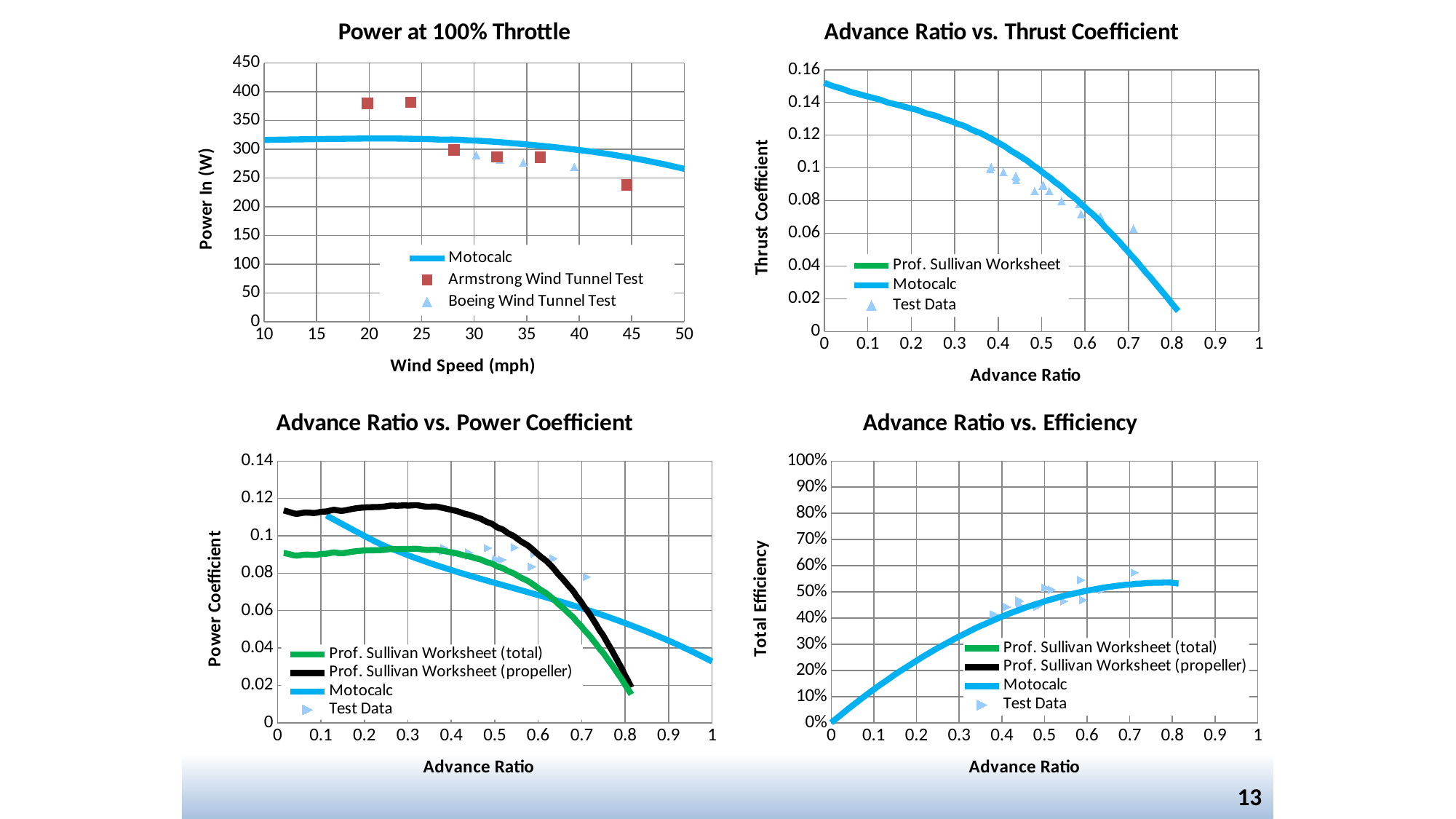
In the 'Power at 100% Throttle' chart, is the Motocalc value at 50 mph greater or less than 300? less In the 'Power at 100% Throttle' chart, does the Motocalc line rise or fall as wind speed increases? fall In the 'Advance Ratio vs. Thrust Coefficient' chart, is the Motocalc value at an advance ratio of 0 greater or less than 0.14? greater In the 'Power at 100% Throttle' chart, how many series does the legend list? 3 In the 'Advance Ratio vs. Thrust Coefficient' chart, does the Motocalc line rise or fall as advance ratio increases? fall In the 'Advance Ratio vs. Power Coefficient' chart, at an advance ratio of 0.1, which is larger: Prof. Sullivan Worksheet (propeller) or Prof. Sullivan Worksheet (total)? Prof. Sullivan Worksheet (propeller) In the 'Advance Ratio vs. Efficiency' chart, is the Motocalc value at an advance ratio of 0.8 greater or less than 50%? greater How many charts are shown on the slide? 4 In the 'Advance Ratio vs. Thrust Coefficient' chart, how many series does the legend list? 3 In the 'Advance Ratio vs. Power Coefficient' chart, how many series does the legend list? 4 In the 'Power at 100% Throttle' chart, what is the label of the x axis? Wind Speed (mph)